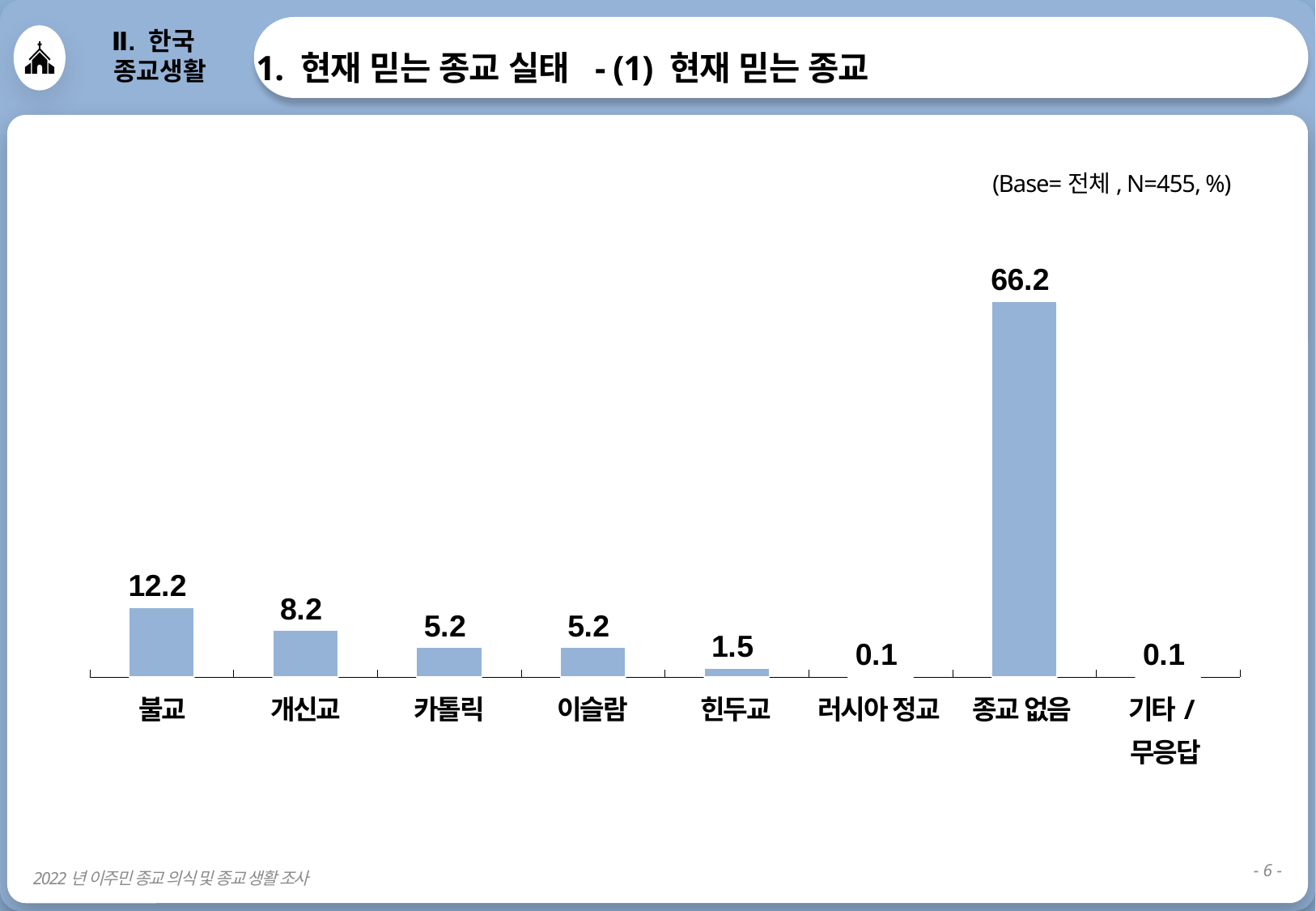
Which is larger, the value for 개신교 or the value for 카톨릭? 개신교 What is the value for 불교? 12.2 What is the difference between the values for 종교 없음 and 불교? 54.0 How many categories are shown on the x axis? 8 Which category has the highest value? 종교 없음 What is the sample size (N) stated on the slide? 455 What is the value for 힌두교? 1.5 What is the value for 종교 없음? 66.2 What is the difference between the values for 불교 and 개신교? 4.0 What kind of chart is shown on the slide? bar chart Which two categories share the value 0.1? 러시아 정교 and 기타 / 무응답 What is the value for 개신교? 8.2